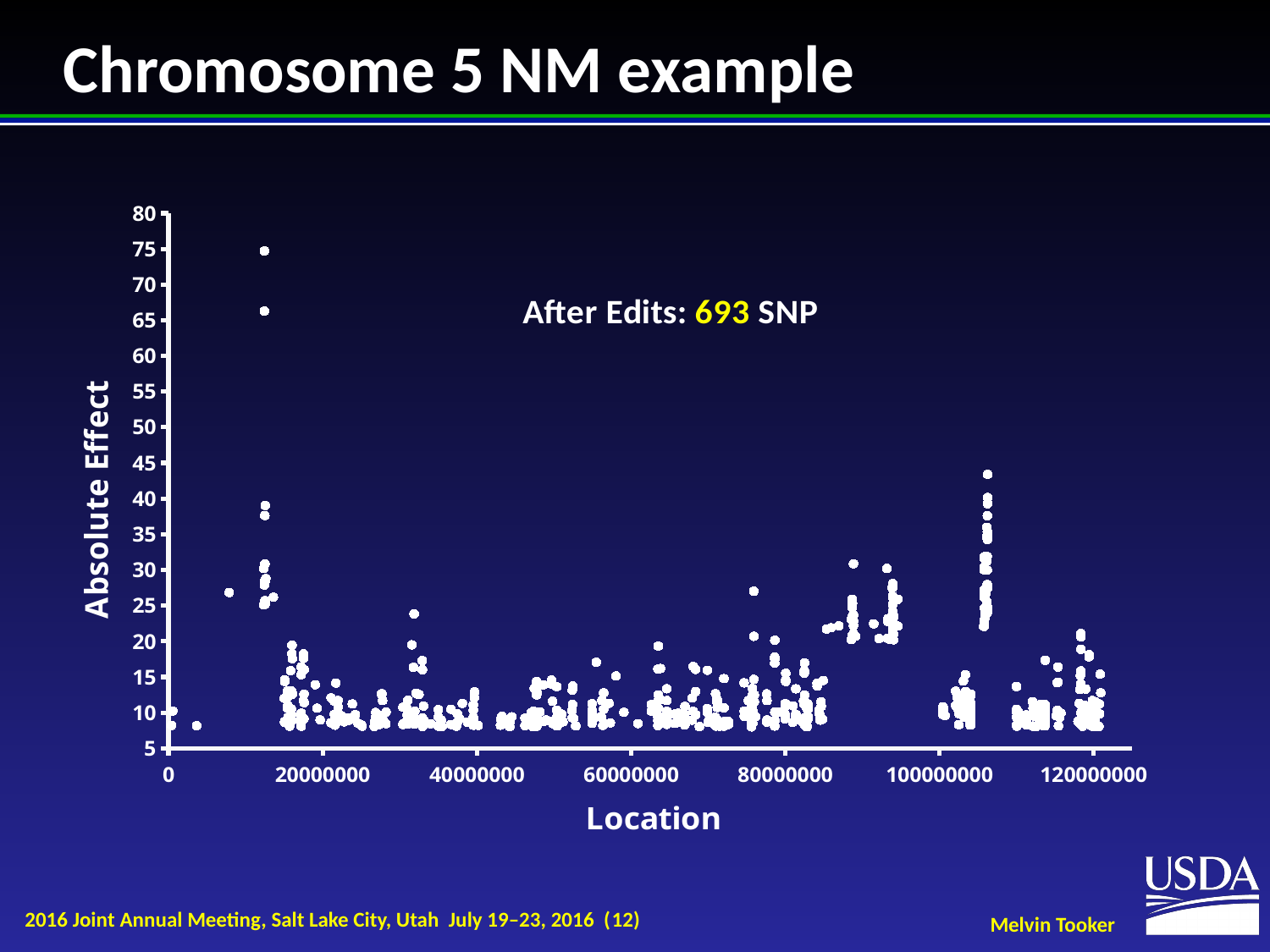
What is the maximum value shown on the y axis? 80 What is the title of the chart's y axis? Absolute Effect Is the lowest plotted absolute effect greater or less than 10? less Is the highest point in the cluster near location 106000000 greater or less than 40? greater What kind of chart is shown on the slide? scatter plot Which has the higher peak absolute effect: the cluster near location 12000000 or the cluster near location 106000000? the cluster near location 12000000 Is the highest point near location 32000000 greater or less than 30? less According to the annotation on the chart, how many SNP remain after edits? 693